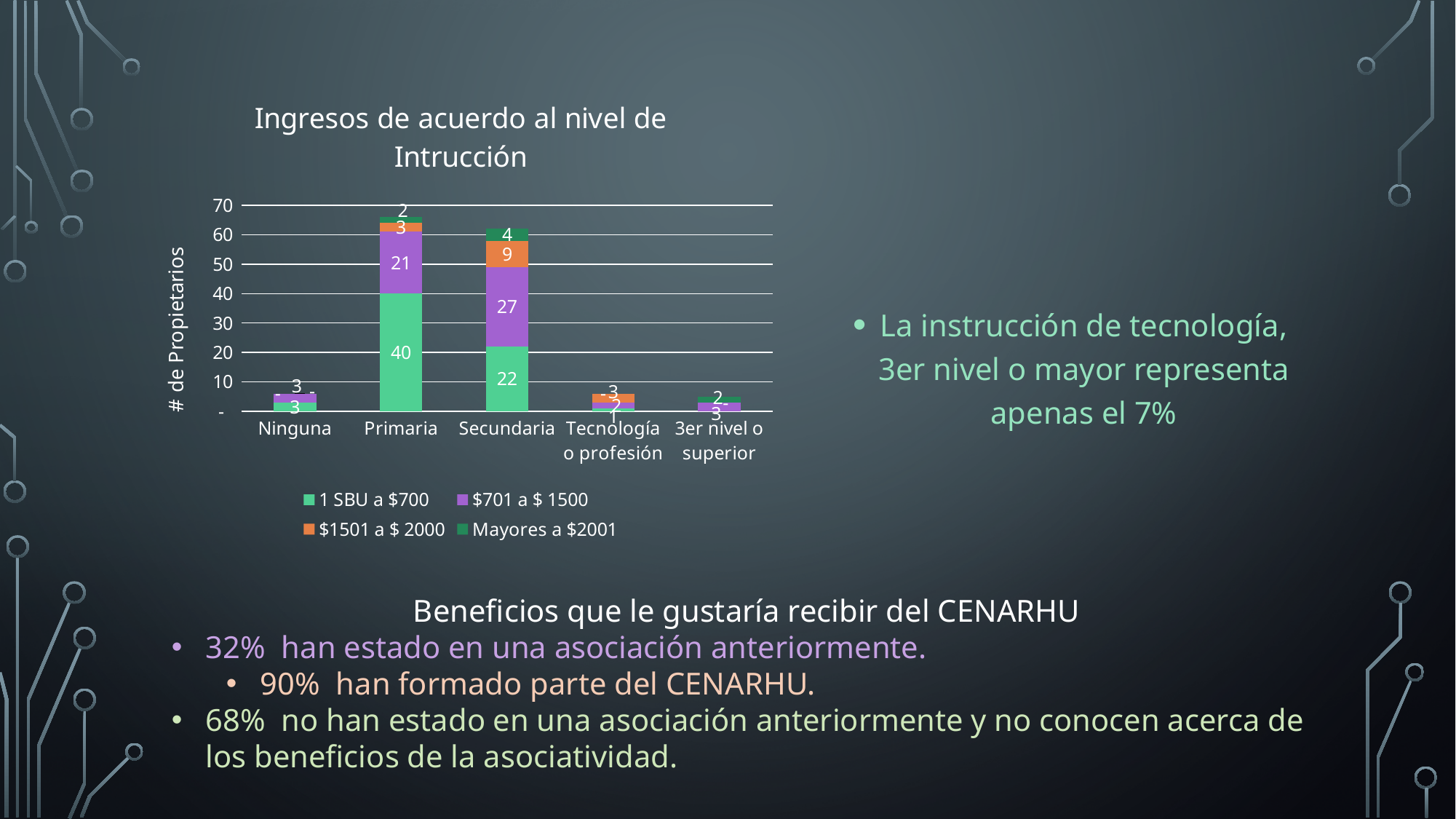
What kind of chart is 'Ingresos de acuerdo al nivel de Intrucción'? Stacked bar chart In the chart 'Ingresos de acuerdo al nivel de Intrucción', what is the value for '1 SBU a $700' in the Primaria category? 40 In the chart 'Ingresos de acuerdo al nivel de Intrucción', what is the value for '$701 a $ 1500' in the Secundaria category? 27 In the chart 'Ingresos de acuerdo al nivel de Intrucción', what is the total of the stacked bar for Secundaria? 62 In the chart 'Ingresos de acuerdo al nivel de Intrucción', what is the total of the stacked bar for Primaria? 66 In the chart 'Ingresos de acuerdo al nivel de Intrucción', which category has the larger '$701 a $ 1500' value, Primaria or Secundaria? Secundaria In the chart 'Ingresos de acuerdo al nivel de Intrucción', how many categories are shown on the x axis? 5 In the chart 'Ingresos de acuerdo al nivel de Intrucción', how many series does the legend list? 4 In the chart 'Ingresos de acuerdo al nivel de Intrucción', what is the value for 'Mayores a $2001' in the Secundaria category? 4 In the chart 'Ingresos de acuerdo al nivel de Intrucción', what is the value for '$1501 a $ 2000' in the Secundaria category? 9 In the chart 'Ingresos de acuerdo al nivel de Intrucción', what is the difference between the '1 SBU a $700' values for Primaria and Secundaria? 18 In the chart 'Ingresos de acuerdo al nivel de Intrucción', is the total stacked value for Ninguna greater or less than 10? less